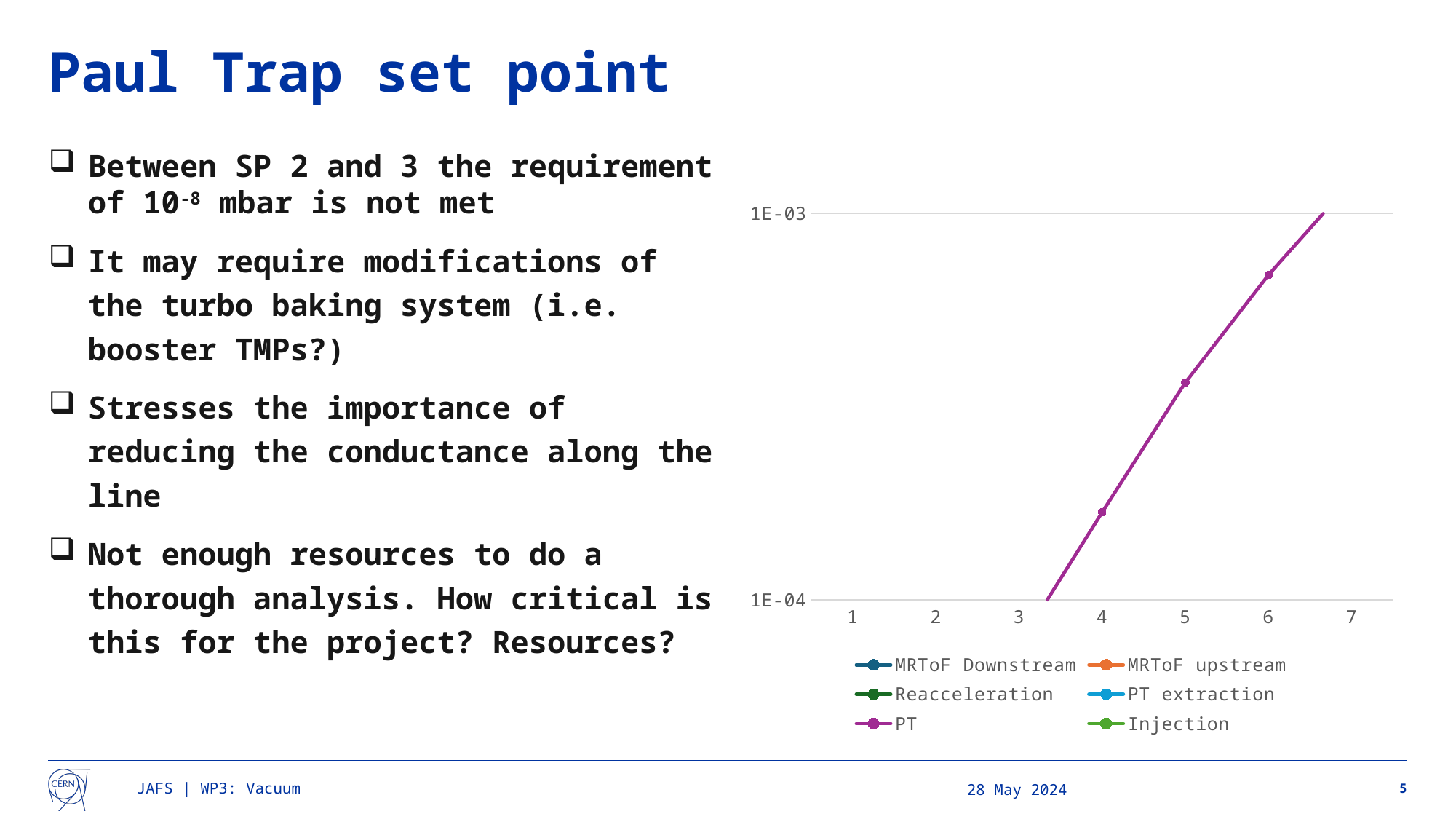
Among the marked PT data points, at which x value is the value highest? 6 Is the PT value at x = 5 greater or less than 1E-03? less Which is larger, the PT value at x = 6 or the PT value at x = 4? x = 6 How many marked data points are visible on the PT line? 3 What kind of chart is shown on the slide? line chart Which series is the only one visibly plotted on the chart? PT What colour is the PT series in the legend? magenta Among the marked PT data points, at which x value is the value lowest? 4 Does the PT line rise or fall as the x value increases from 4 to 6? rises Is the PT value at x = 4 greater or less than 1E-04? greater Is the PT value at x = 6 greater or less than 1E-03? less How many series does the chart legend list? 6